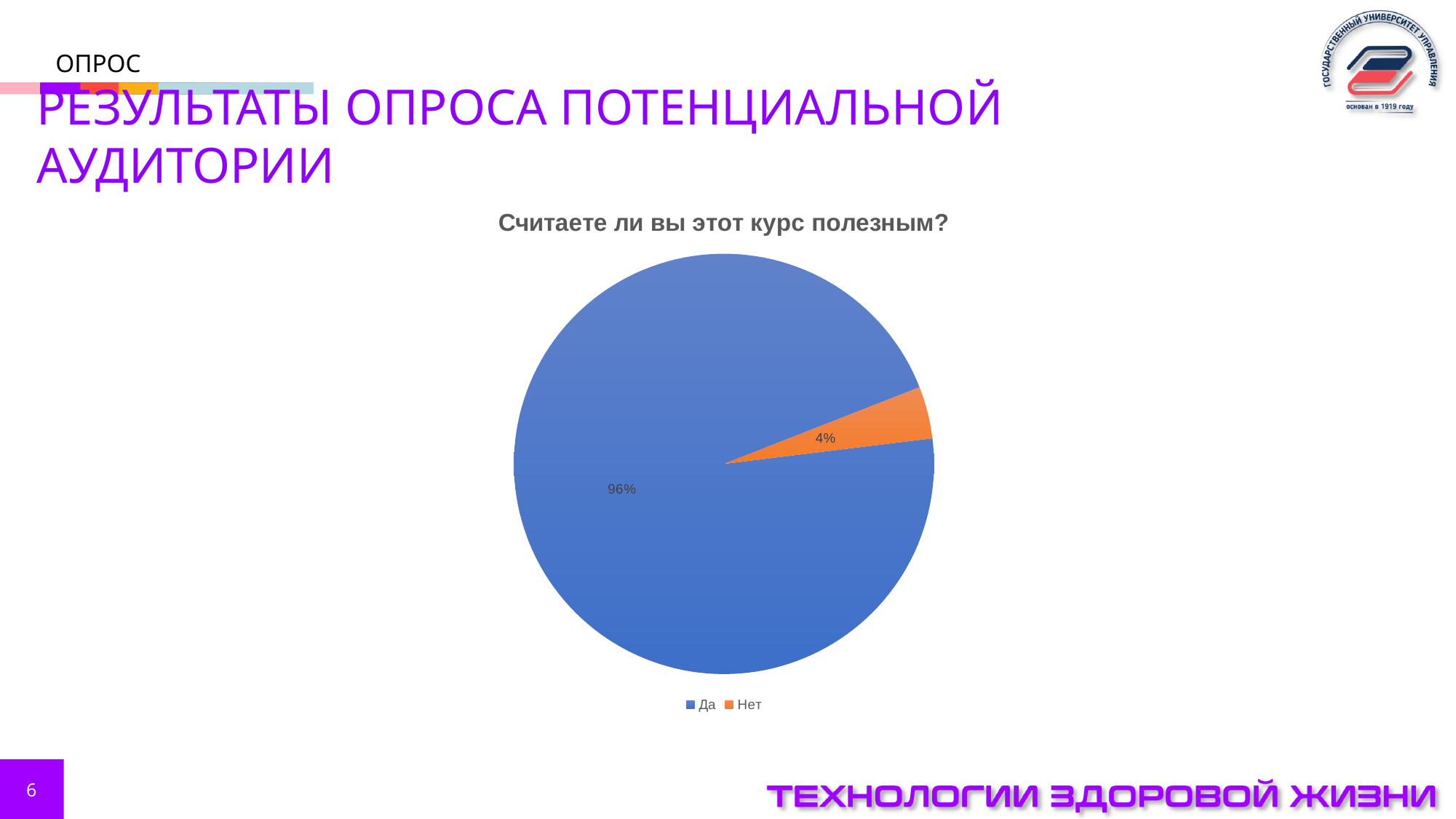
What colour is the "Нет" slice? Orange Which is larger, the "Да" slice or the "Нет" slice? Да How many entries does the legend list? 2 What is the difference in percentage points between the "Да" and "Нет" slices? 92 Which category has the largest slice of the pie? Да What share of the pie does "Нет" take? 4% Which category has the smallest slice of the pie? Нет What is the title of the chart? Считаете ли вы этот курс полезным? What share of the pie does "Да" take? 96% How many categories are shown in the pie chart? 2 What kind of chart is shown on the slide? Pie chart